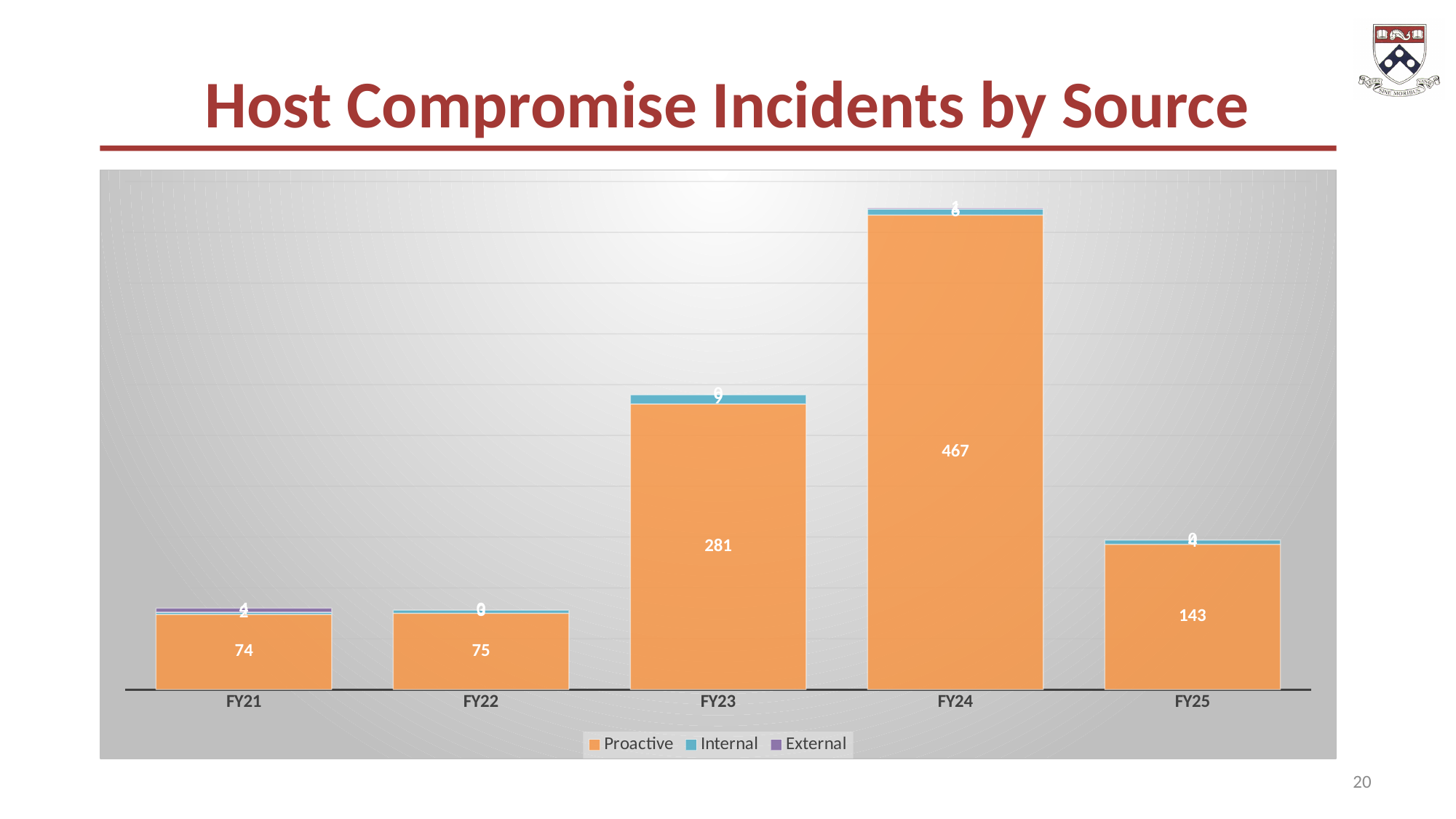
What is the title of the chart? Host Compromise Incidents by Source What is the Proactive value for FY24? 467 Which is larger, the Proactive value for FY23 or for FY25? FY23 Which fiscal year has the highest Proactive value? FY24 What kind of chart is shown on the slide? Stacked bar chart Which fiscal year has the lowest Proactive value? FY21 What is the Proactive value for FY23? 281 How many series does the legend list? 3 What is the Proactive value for FY25? 143 How many fiscal years are shown on the x axis? 5 What is the Proactive value for FY21? 74 What is the difference between the Proactive values for FY24 and FY23? 186